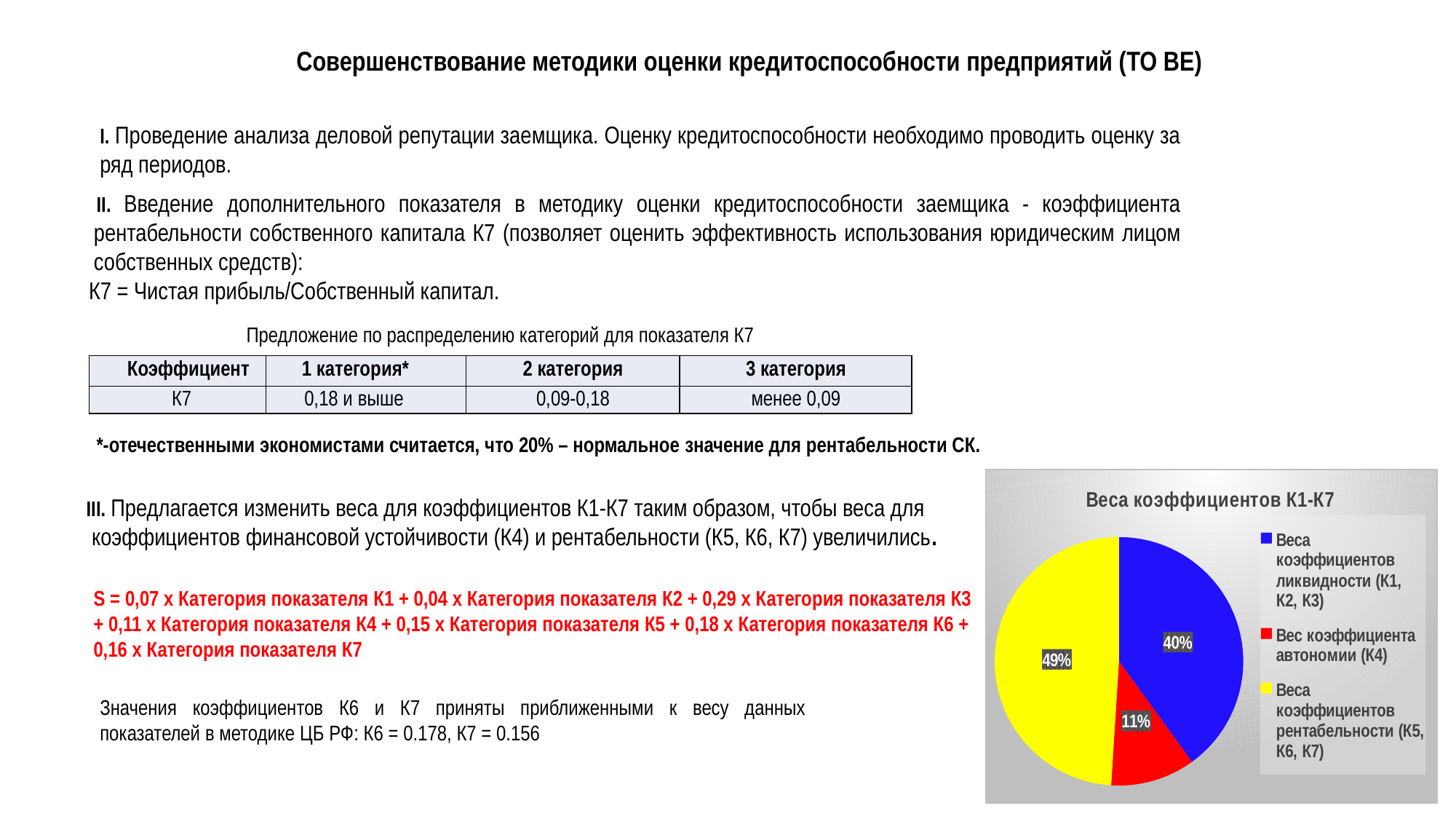
What share of the pie is labelled for the profitability coefficients (К5, К6, К7)? 49% How many slices does the pie chart have? 3 What is the title of the chart? Веса коэффициентов К1-К7 What colour is the slice for the autonomy coefficient (К4)? red What kind of chart is shown on the slide? pie chart What share of the pie is labelled for the autonomy coefficient (К4)? 11% What is the difference between the share for the profitability coefficients (К5, К6, К7) and the share for the liquidity coefficients (К1, К2, К3)? 9% How many entries does the chart legend list? 3 Which slice of the pie is the largest? Веса коэффициентов рентабельности (К5, К6, К7) Which is larger: the share for the liquidity coefficients (К1, К2, К3) or the share for the autonomy coefficient (К4)? Веса коэффициентов ликвидности (К1, К2, К3) Which slice of the pie is the smallest? Вес коэффициента автономии (К4) What share of the pie is labelled for the liquidity coefficients (К1, К2, К3)? 40%